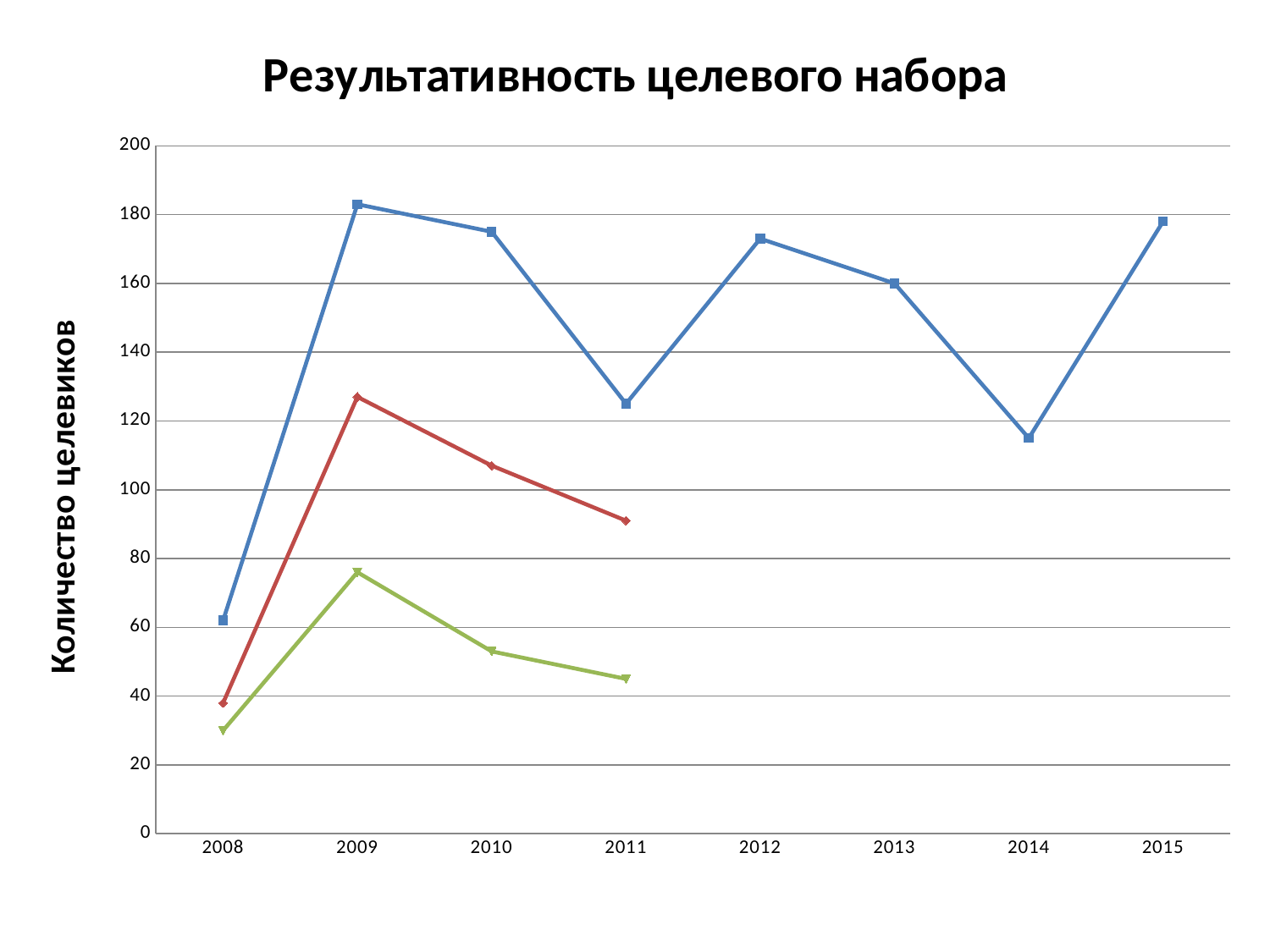
In which year does the blue line have its lowest value? 2008 What is the label on the vertical axis of the chart? Количество целевиков Does the red line rise or fall from 2009 to 2011? fall Is the value of the green line for 2009 greater or less than 80? less Is the value of the blue line for 2011 greater or less than 140? less How many years are shown along the x axis of the chart? 8 In which year does the blue line reach its highest value? 2009 For the blue line, which year has the larger value, 2012 or 2014? 2012 Is the value of the red line for 2009 greater or less than 120? greater What kind of chart is shown on the slide? line chart What is the title of the chart? Результативность целевого набора How many lines are plotted on the chart? 3